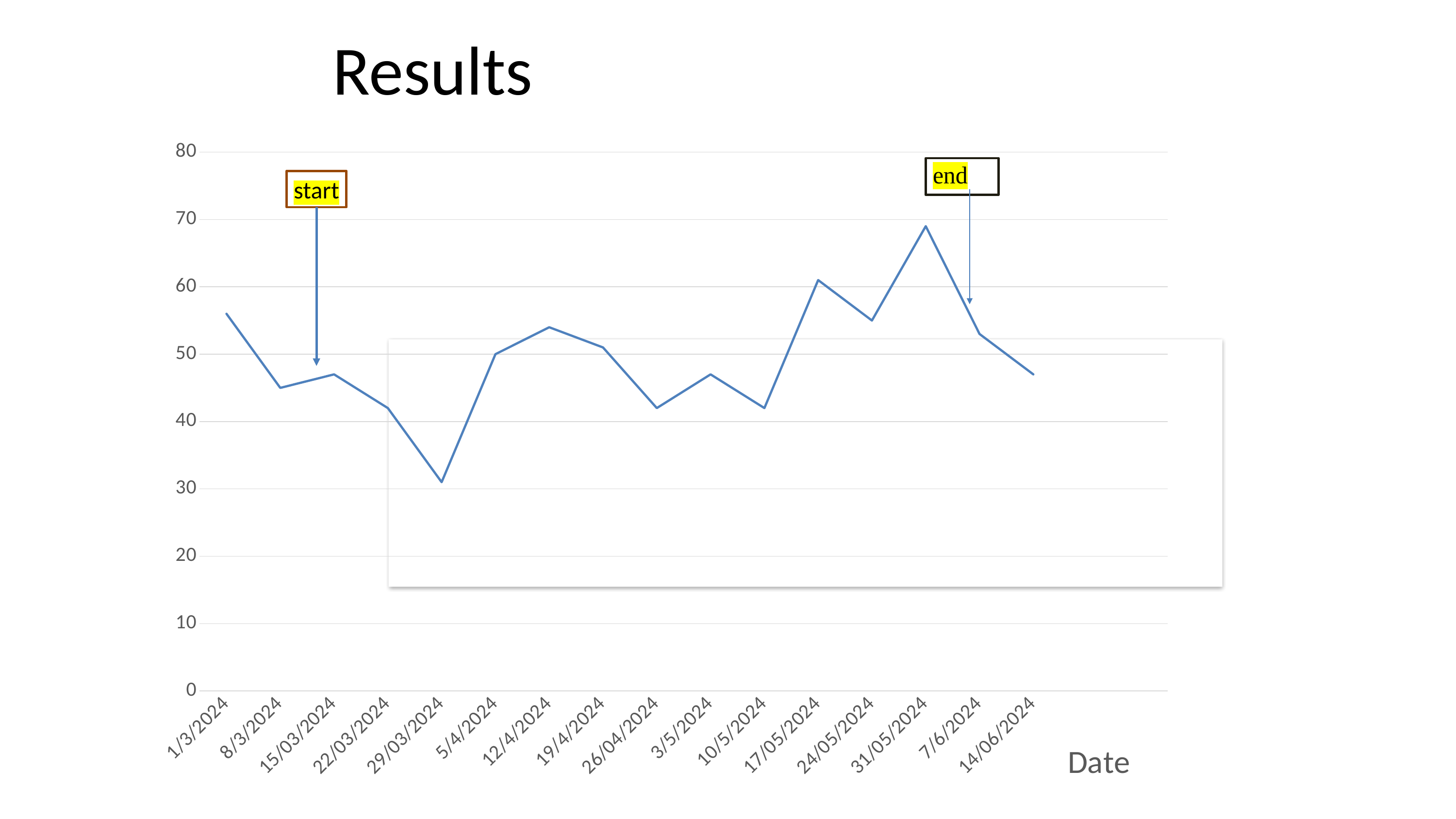
Which date has the larger value, 1/3/2024 or 8/3/2024? 1/3/2024 How many dates are plotted along the x axis of the chart? 16 What is the label on the x axis of the chart? Date On which date does the line reach its lowest value? 29/03/2024 Is the value for 31/05/2024 greater or less than 60? greater What kind of chart is shown on the slide? line chart Is the value for 1/3/2024 greater or less than 50? greater Is the value for 26/04/2024 greater or less than 50? less On which date does the line reach its highest value? 31/05/2024 Between 31/05/2024 and 14/06/2024, does the line rise or fall? fall What is the title of the slide containing the chart? Results